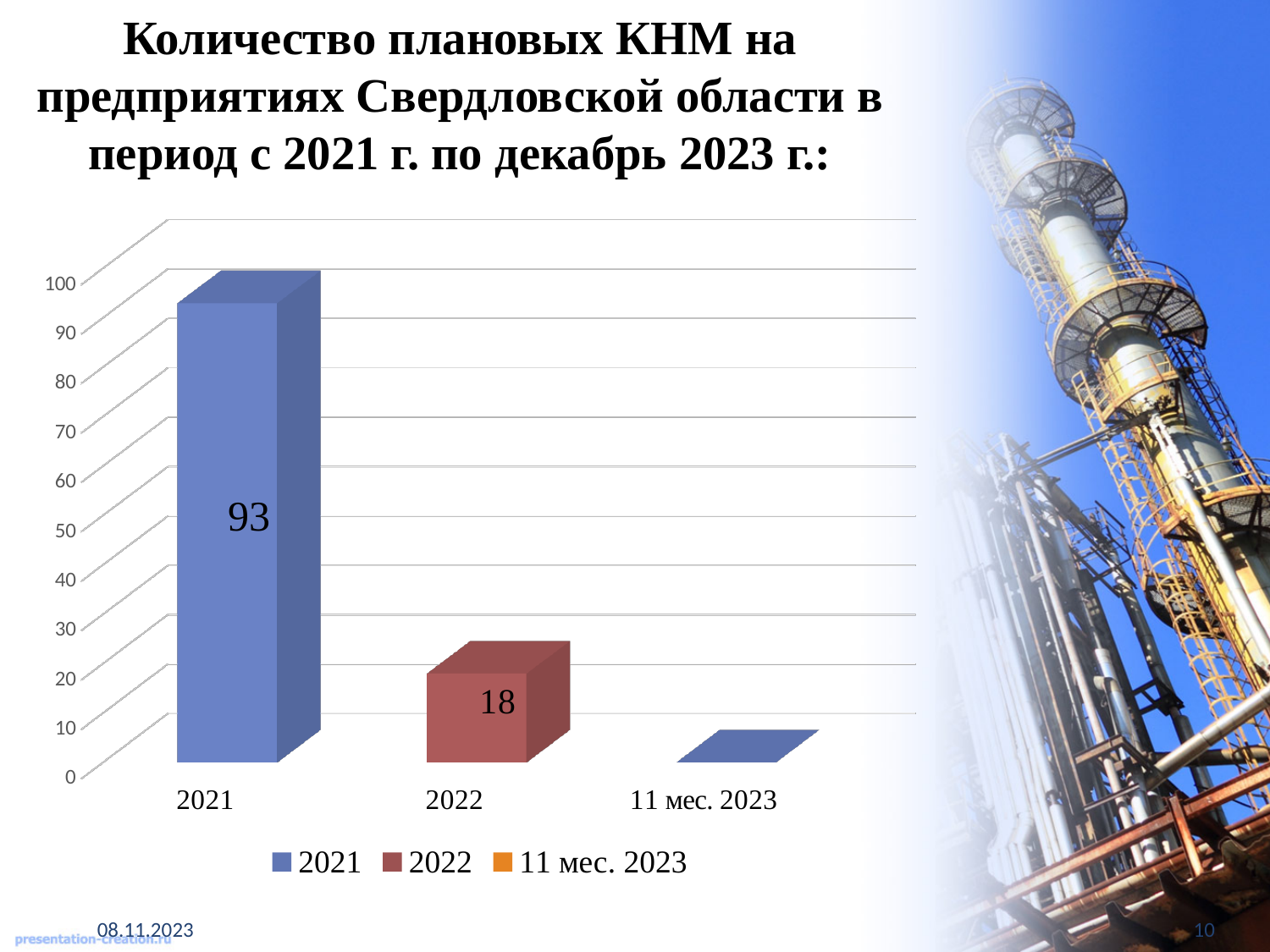
What is the highest tick value shown on the vertical axis? 100 Is the value for 11 мес. 2023 greater or less than 10? less How many categories are shown on the x axis? 3 Do the values rise or fall from 2021 to 11 мес. 2023? fall What kind of chart is shown on the slide? bar chart What is the value for 2022? 18 Which is larger, the value for 2021 or the value for 2022? 2021 What is the value for 2021? 93 Which category has the highest value? 2021 Which category has the lowest value? 11 мес. 2023 What is the difference between the values for 2021 and 2022? 75 How many entries does the legend list? 3